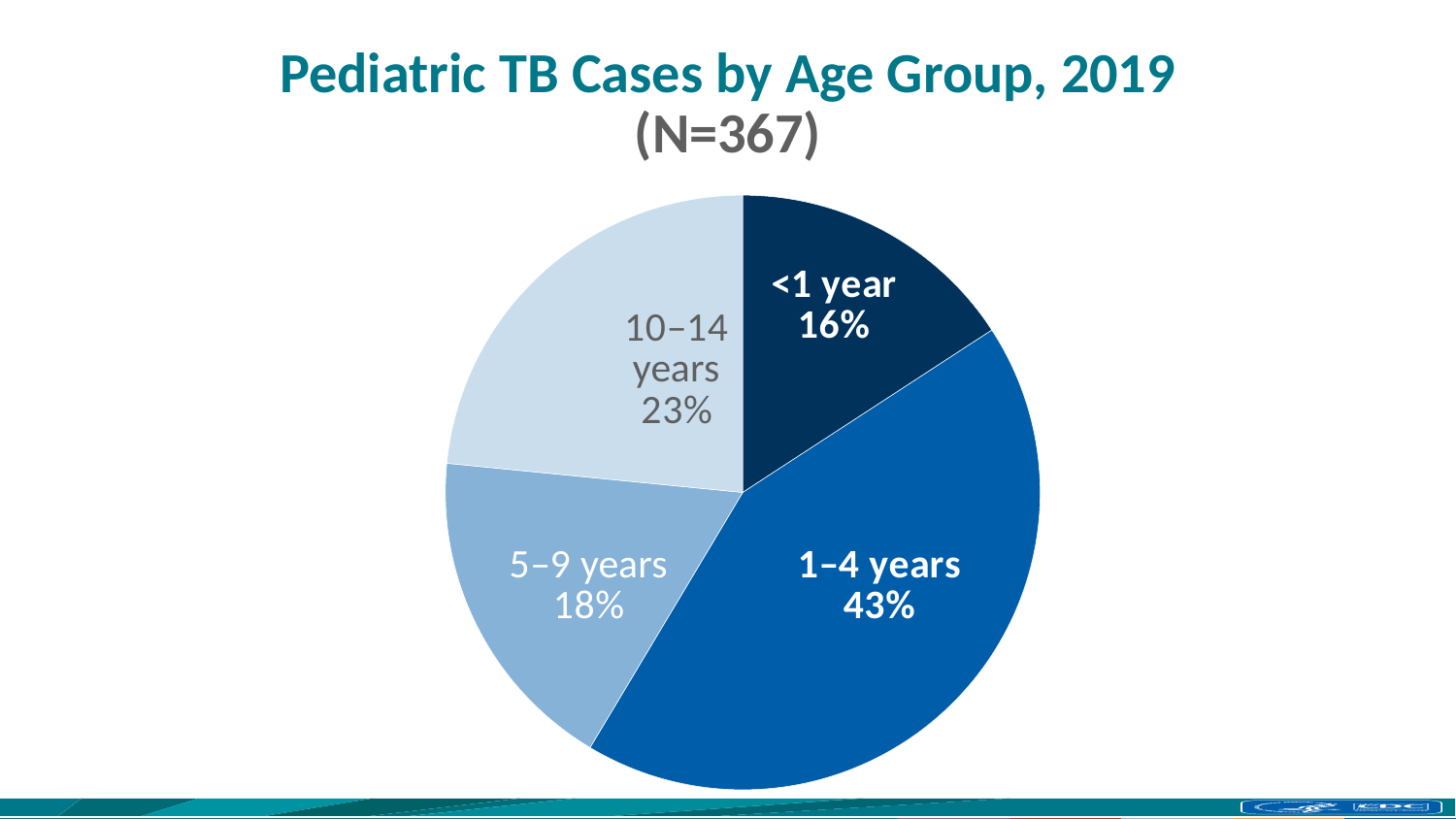
What is the total number of cases (N) stated in the chart title? 367 What share of pediatric TB cases is in the <1 year age group? 16% What kind of chart is shown on the slide? pie chart What is the difference in percentage points between the 1–4 years and 10–14 years shares? 20 What share of pediatric TB cases is in the 1–4 years age group? 43% What share of pediatric TB cases is in the 10–14 years age group? 23% What is the title of the chart? Pediatric TB Cases by Age Group, 2019 (N=367) How many age groups are shown in the pie chart? 4 Which share is larger, 5–9 years or 10–14 years? 10–14 years Which age group has the largest share of pediatric TB cases? 1–4 years Which age group has the smallest share of pediatric TB cases? <1 year